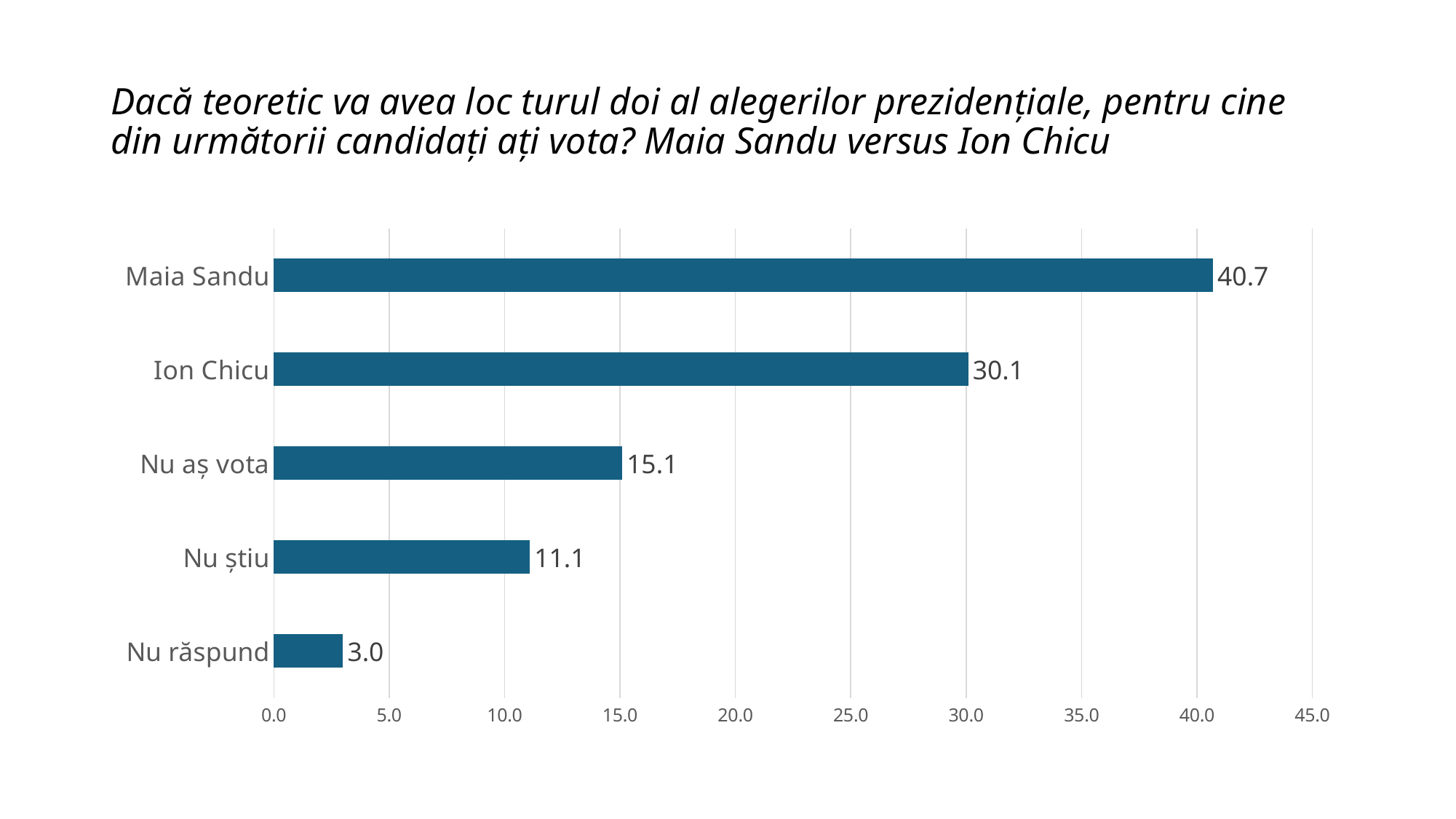
Which category has the highest value? Maia Sandu Which is larger, the value for Nu aș vota or the value for Nu știu? Nu aș vota What is the value for Nu răspund? 3.0 What is the value for Maia Sandu? 40.7 What is the value for Ion Chicu? 30.1 Is the value for Nu știu greater or less than 10.0? greater What kind of chart is shown on the slide? bar chart What is the value for Nu aș vota? 15.1 Which category has the lowest value? Nu răspund What is the highest value shown on the x axis? 45.0 What is the difference between the values for Maia Sandu and Ion Chicu? 10.6 How many categories are shown in the chart? 5